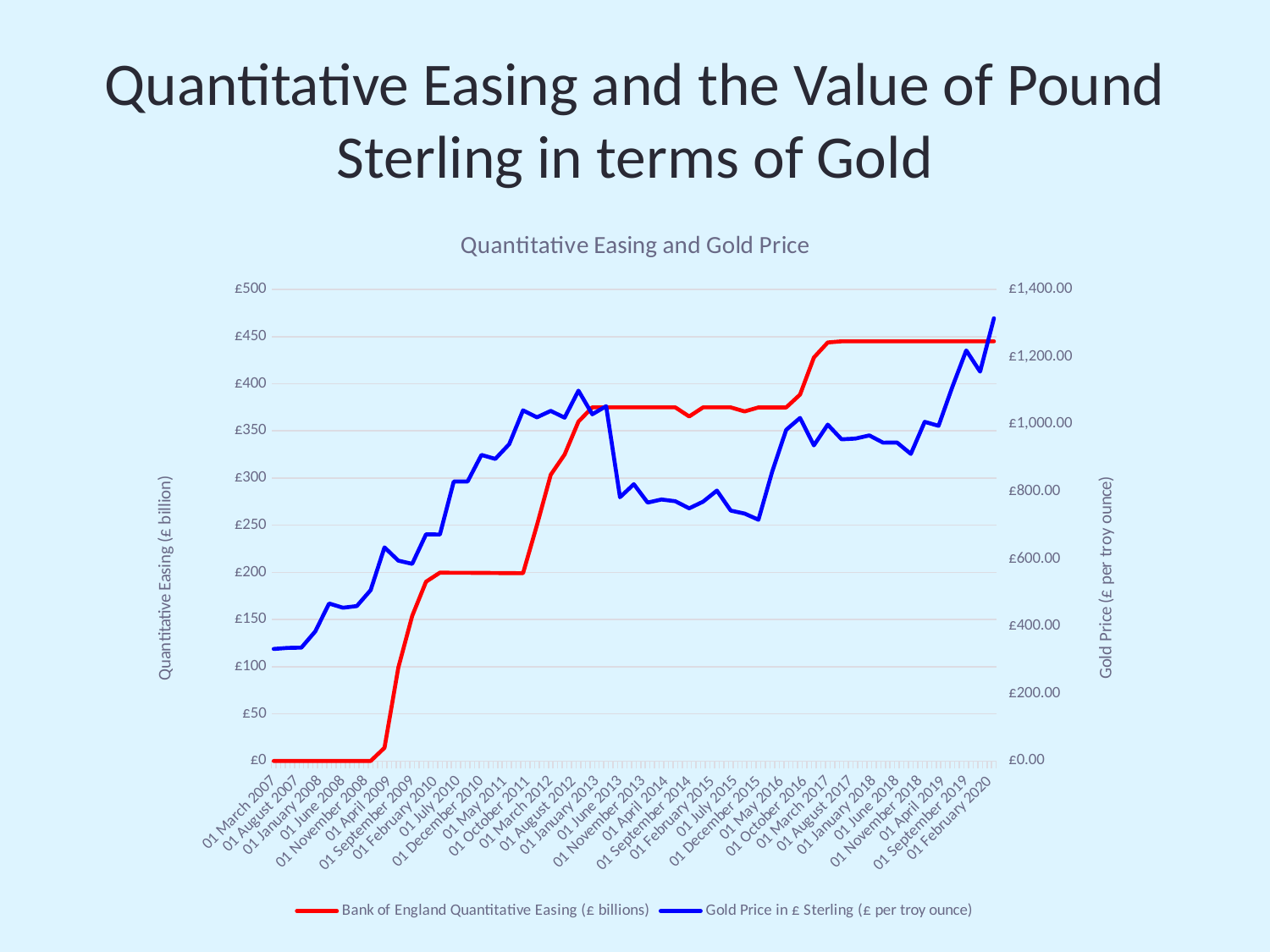
Is the value of Bank of England Quantitative Easing (£ billions) at 01 July 2010 greater or less than £150? greater What is the value of Bank of England Quantitative Easing (£ billions) at 01 March 2007? £0 What is the title of the chart? Quantitative Easing and Gold Price Overall, does the Bank of England Quantitative Easing (£ billions) line rise or fall from 01 March 2007 to 01 February 2020? Rise Is the Gold Price in £ Sterling (£ per troy ounce) at 01 February 2020 greater or less than £1,200.00? greater Is the value of Bank of England Quantitative Easing (£ billions) at 01 February 2020 greater or less than £400? greater What kind of chart is shown on the slide? Line chart What colour is the line for Gold Price in £ Sterling (£ per troy ounce)? Blue At which date does the Gold Price in £ Sterling (£ per troy ounce) reach its highest value? 01 February 2020 How many series does the chart's legend list? 2